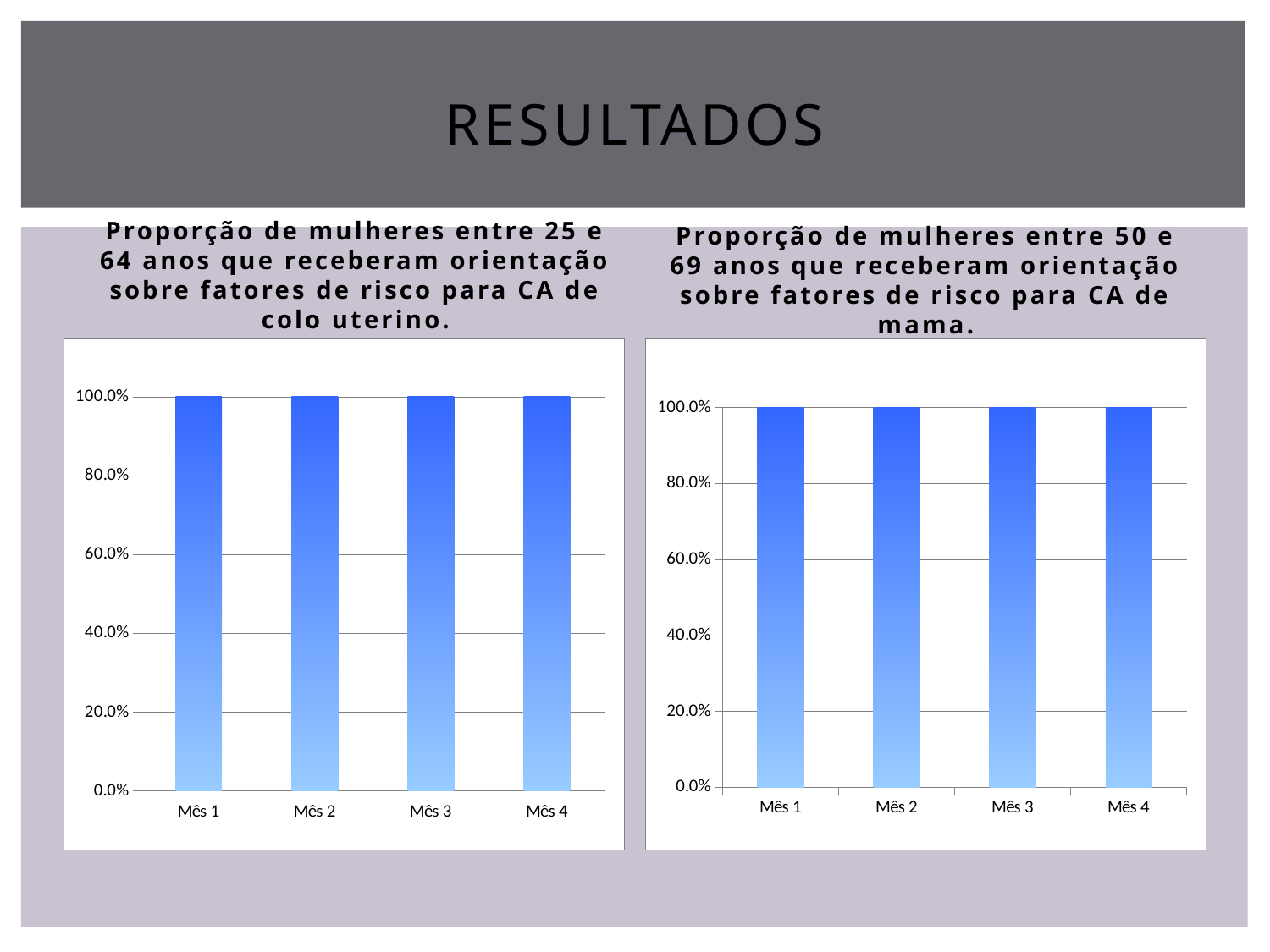
How many categories (months) are shown in the left chart (CA de colo uterino)? 4 In the right chart (CA de mama), what is the value for Mês 2? 100.0% In the left chart (CA de colo uterino), what is the value for Mês 1? 100.0% In the left chart (CA de colo uterino), do the values rise, fall, or stay the same from Mês 1 to Mês 4? Stay the same What kind of chart is the right chart (CA de mama)? Bar chart In the right chart (CA de mama), what is the value for Mês 4? 100.0% In the left chart (CA de colo uterino), what is the value for Mês 3? 100.0% In the right chart (CA de mama), is the value for Mês 3 greater or less than 80.0%? greater In the left chart (CA de colo uterino), what is the difference between the values for Mês 2 and Mês 4? 0.0% What is the title of the right chart? Proporção de mulheres entre 50 e 69 anos que receberam orientação sobre fatores de risco para CA de mama. What kind of chart is the left chart (CA de colo uterino)? Bar chart How many bars are plotted in the right chart (CA de mama)? 4